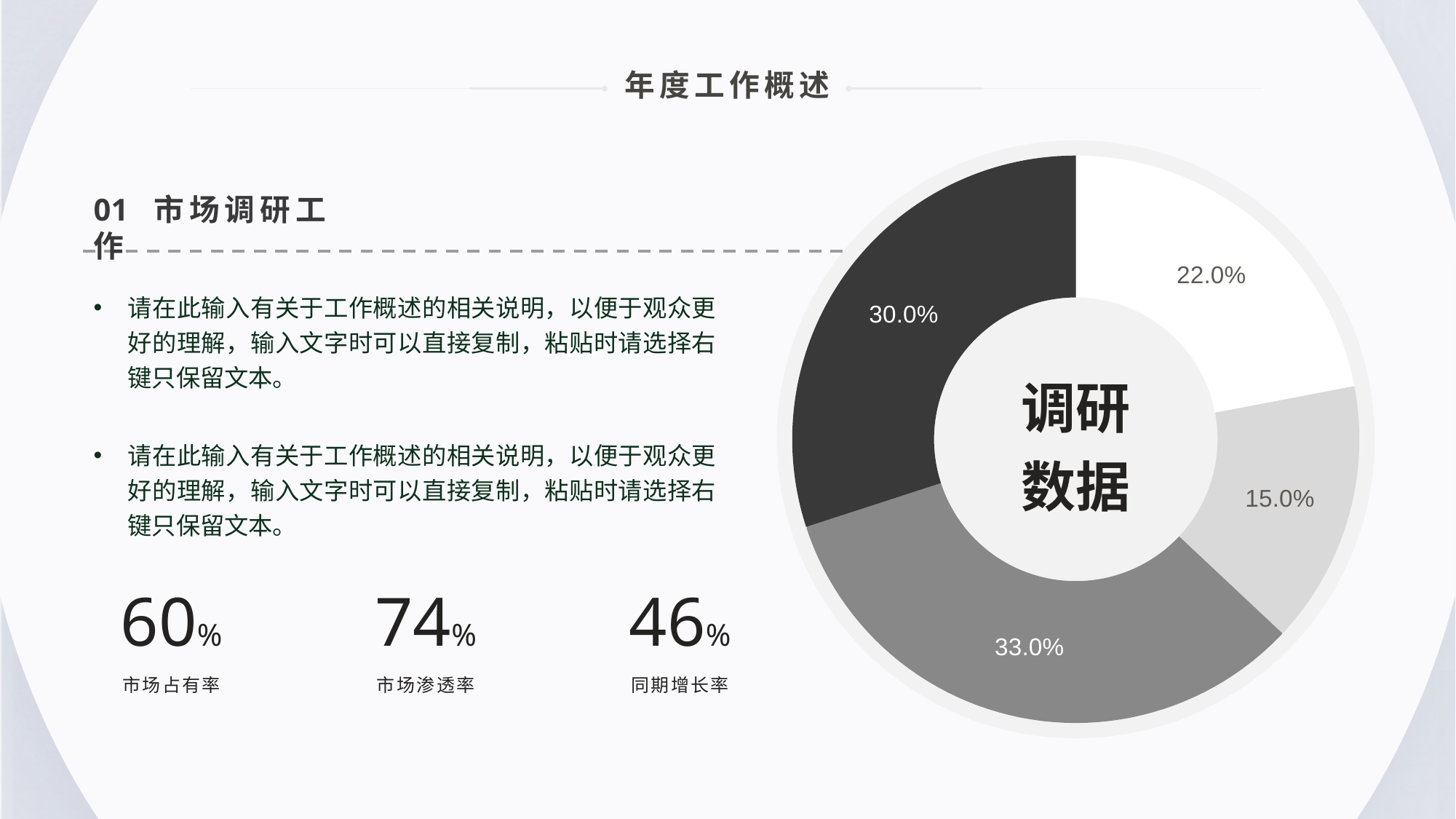
What value is labelled on the light grey slice on the right side of the doughnut chart? 15.0% Which slice is larger in the doughnut chart, the black slice or the white slice? The black slice (30.0%) How many slices does the doughnut chart have? 4 What is the smallest value shown on the doughnut chart? 15.0% What is the difference between the largest slice (33.0%) and the smallest slice (15.0%) in the doughnut chart? 18.0% What value is labelled on the medium grey slice at the bottom of the doughnut chart? 33.0% What text is written in the centre of the doughnut chart? 调研数据 What value is labelled on the black slice of the doughnut chart? 30.0% What is the largest value shown on the doughnut chart? 33.0% What kind of chart is shown on the slide? Doughnut (pie) chart What value is labelled on the white slice of the doughnut chart? 22.0% What is the sum of the four slice values shown on the doughnut chart? 100.0%